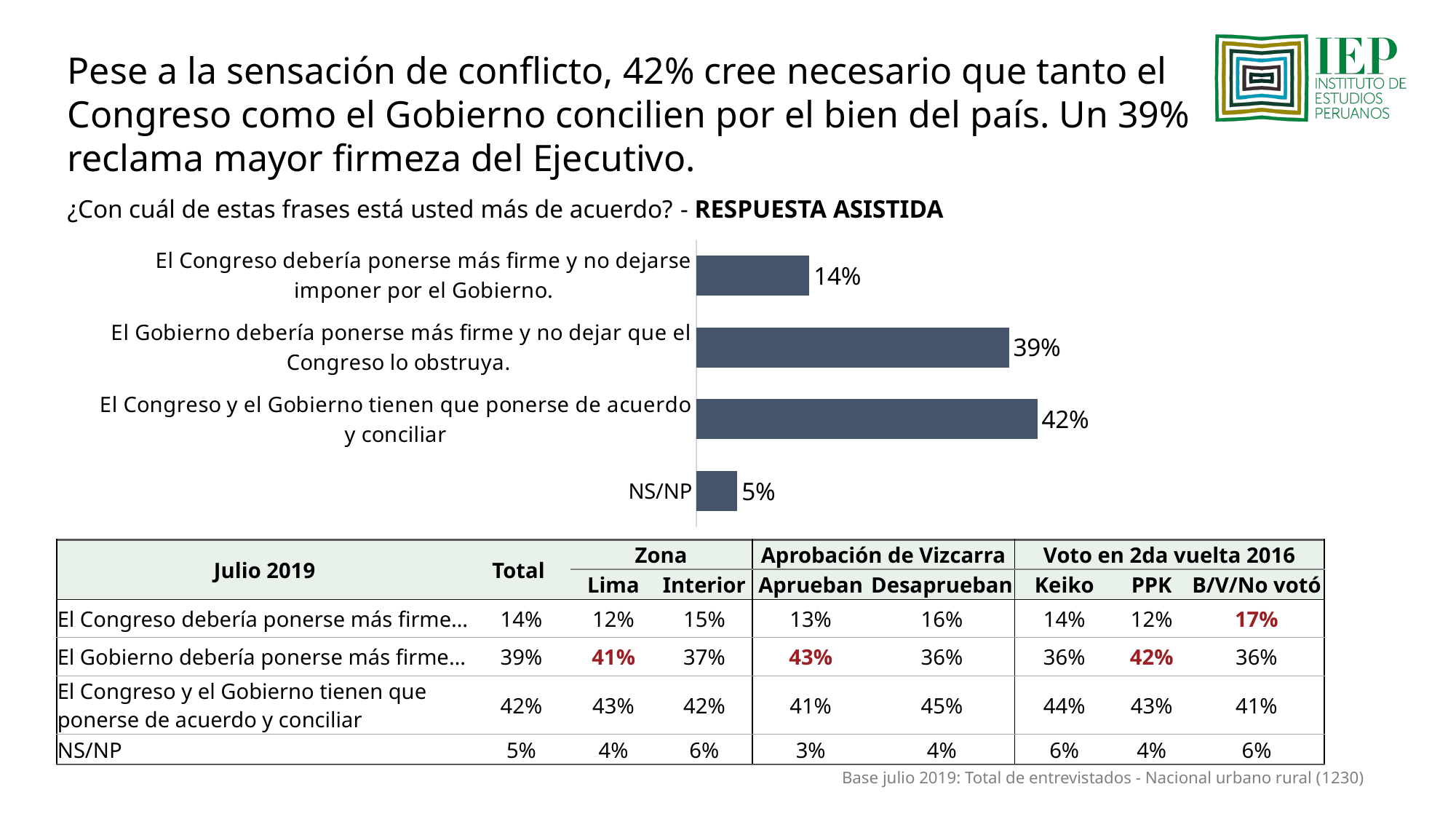
Which response has the lowest value in the bar chart? NS/NP Which response has the highest value in the bar chart? El Congreso y el Gobierno tienen que ponerse de acuerdo y conciliar What is the difference between the value for 'El Gobierno debería ponerse más firme y no dejar que el Congreso lo obstruya' and the value for 'El Congreso debería ponerse más firme y no dejarse imponer por el Gobierno'? 25% What is the value shown for NS/NP in the bar chart? 5% What percentage of respondents chose 'El Congreso y el Gobierno tienen que ponerse de acuerdo y conciliar'? 42% What colour are the bars in the chart? Dark blue-grey What is the difference between the value for 'El Congreso y el Gobierno tienen que ponerse de acuerdo y conciliar' and the value for NS/NP? 37% What is the value shown for 'El Congreso debería ponerse más firme y no dejarse imponer por el Gobierno'? 14% How many response categories are shown in the bar chart? 4 What type of chart is shown on the slide? Bar chart Which is larger: the value for 'El Gobierno debería ponerse más firme...' or the value for 'El Congreso y el Gobierno tienen que ponerse de acuerdo y conciliar'? El Congreso y el Gobierno tienen que ponerse de acuerdo y conciliar What is the survey question shown above the bar chart? ¿Con cuál de estas frases está usted más de acuerdo? - RESPUESTA ASISTIDA